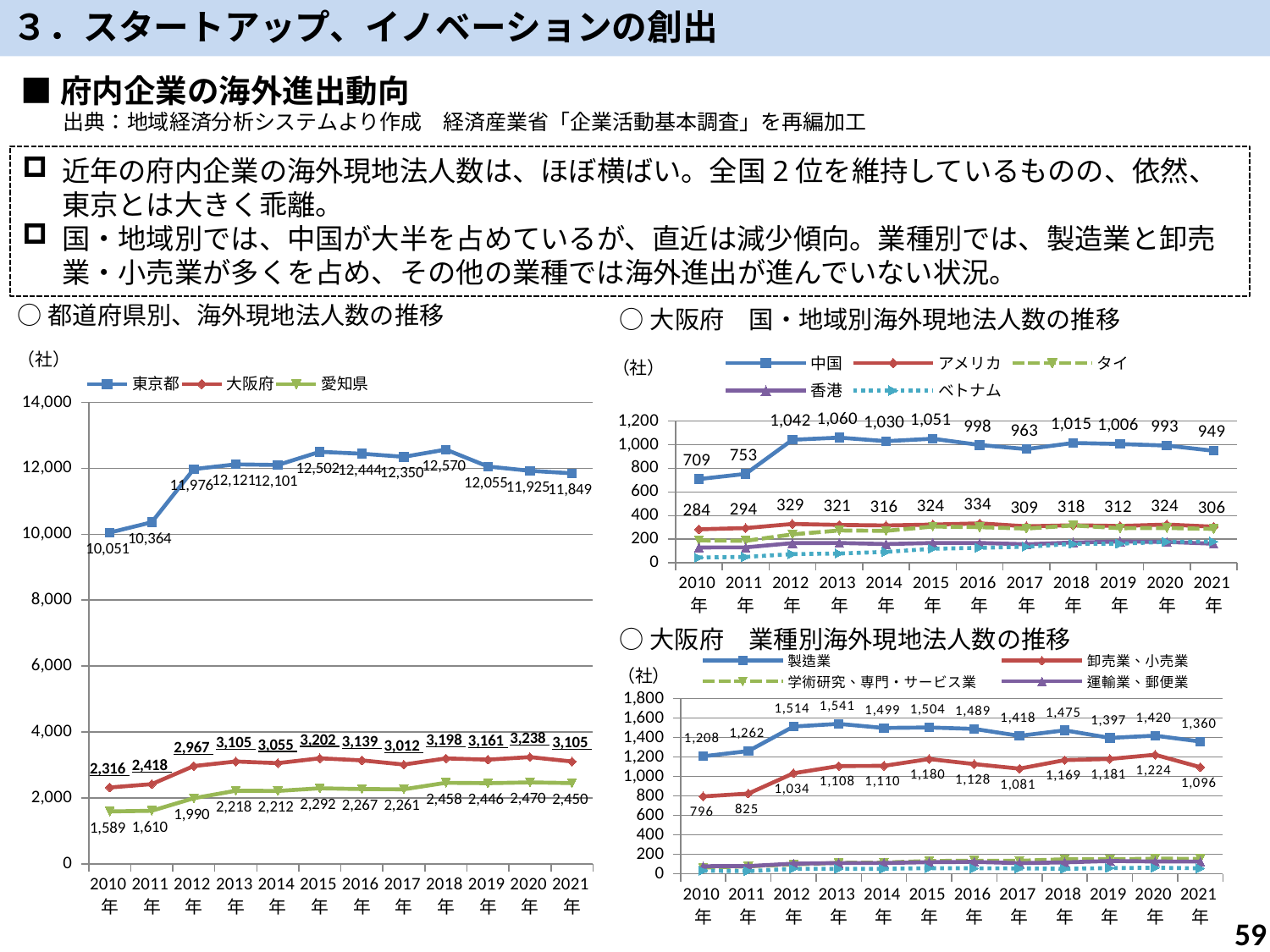
In the chart titled 都道府県別、海外現地法人数の推移, what kind of chart is it? Line chart In the chart titled 大阪府 業種別海外現地法人数の推移, which is larger in 2020年, 製造業 or 卸売業、小売業? 製造業 In the chart titled 都道府県別、海外現地法人数の推移, how many series does the legend list? 3 In the chart titled 都道府県別、海外現地法人数の推移, what is the value for 東京都 in 2021年? 11,849 In the chart titled 都道府県別、海外現地法人数の推移, what is the value for 大阪府 in 2015年? 3,202 In the chart titled 大阪府 業種別海外現地法人数の推移, how many years are shown on the x axis? 12 In the chart titled 大阪府 国・地域別海外現地法人数の推移, how many series does the legend list? 5 In the chart titled 都道府県別、海外現地法人数の推移, what is the difference between 大阪府 and 愛知県 in 2021年? 655 In the chart titled 都道府県別、海外現地法人数の推移, in which year does 東京都 reach its highest value? 2018年 In the chart titled 大阪府 国・地域別海外現地法人数の推移, what is the value for 中国 in 2013年? 1,060 In the chart titled 大阪府 業種別海外現地法人数の推移, what is the value for 製造業 in 2013年? 1,541 In the chart titled 大阪府 国・地域別海外現地法人数の推移, in which year is the value for アメリカ lowest? 2010年